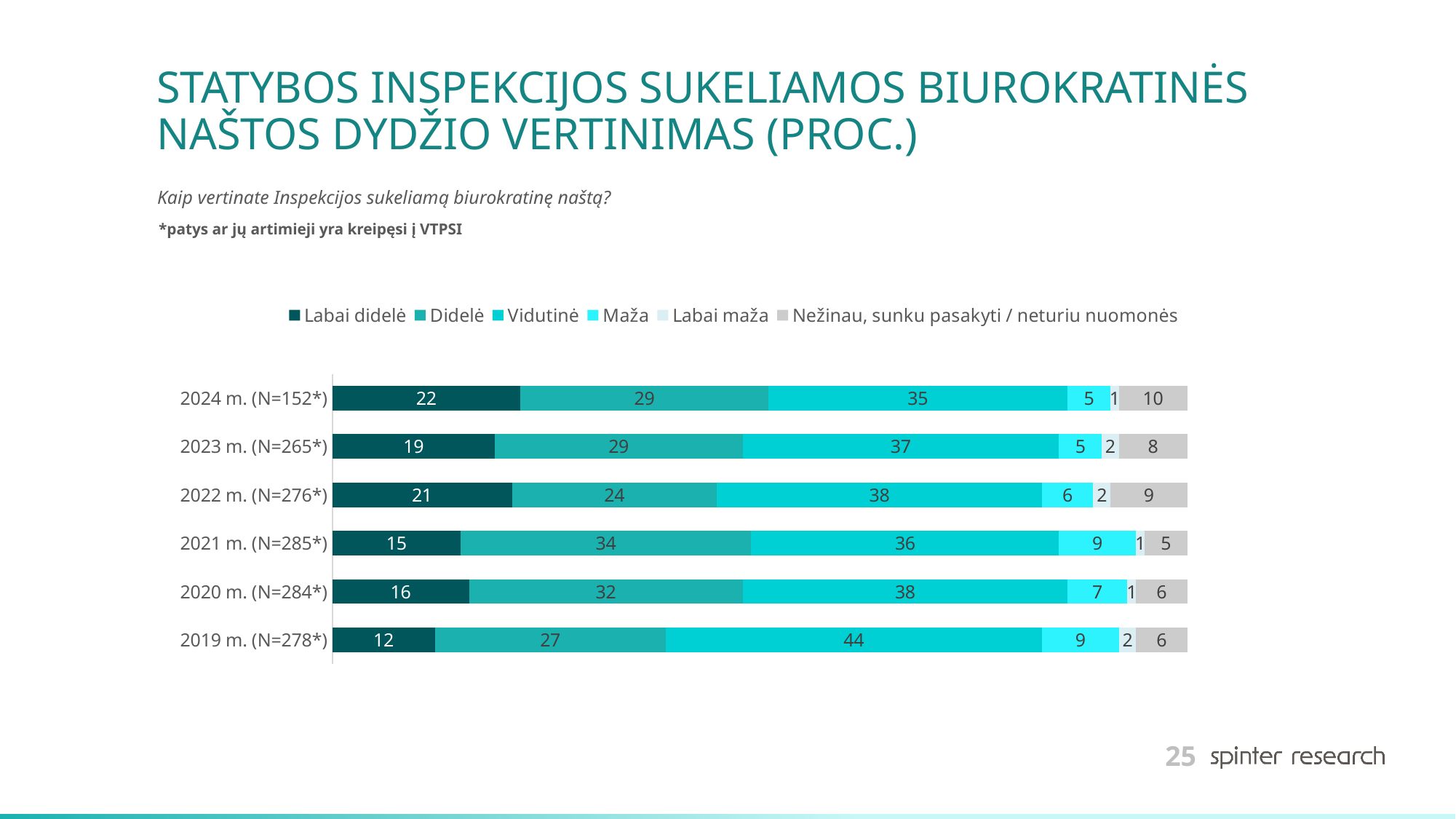
Which legend entry is shown in grey? Nežinau, sunku pasakyti / neturiu nuomonės How many years (categories) are shown in the chart? 6 How many series does the legend list? 6 Which year has the highest value for "Labai didelė"? 2024 m. (N=152*) Which year has the lowest value for "Labai didelė"? 2019 m. (N=278*) What is the value for "Didelė" in 2021 m. (N=285*)? 34 What is the difference between the "Vidutinė" values for 2019 m. (N=278*) and 2024 m. (N=152*)? 9 Which is larger: the "Didelė" value for 2022 m. (N=276*) or for 2020 m. (N=284*)? 2020 m. (N=284*) What kind of chart is shown on the slide? Stacked bar chart What is the total of the stacked bar for 2021 m. (N=285*)? 100 What is the value for "Labai didelė" in 2024 m. (N=152*)? 22 What is the value for "Vidutinė" in 2019 m. (N=278*)? 44